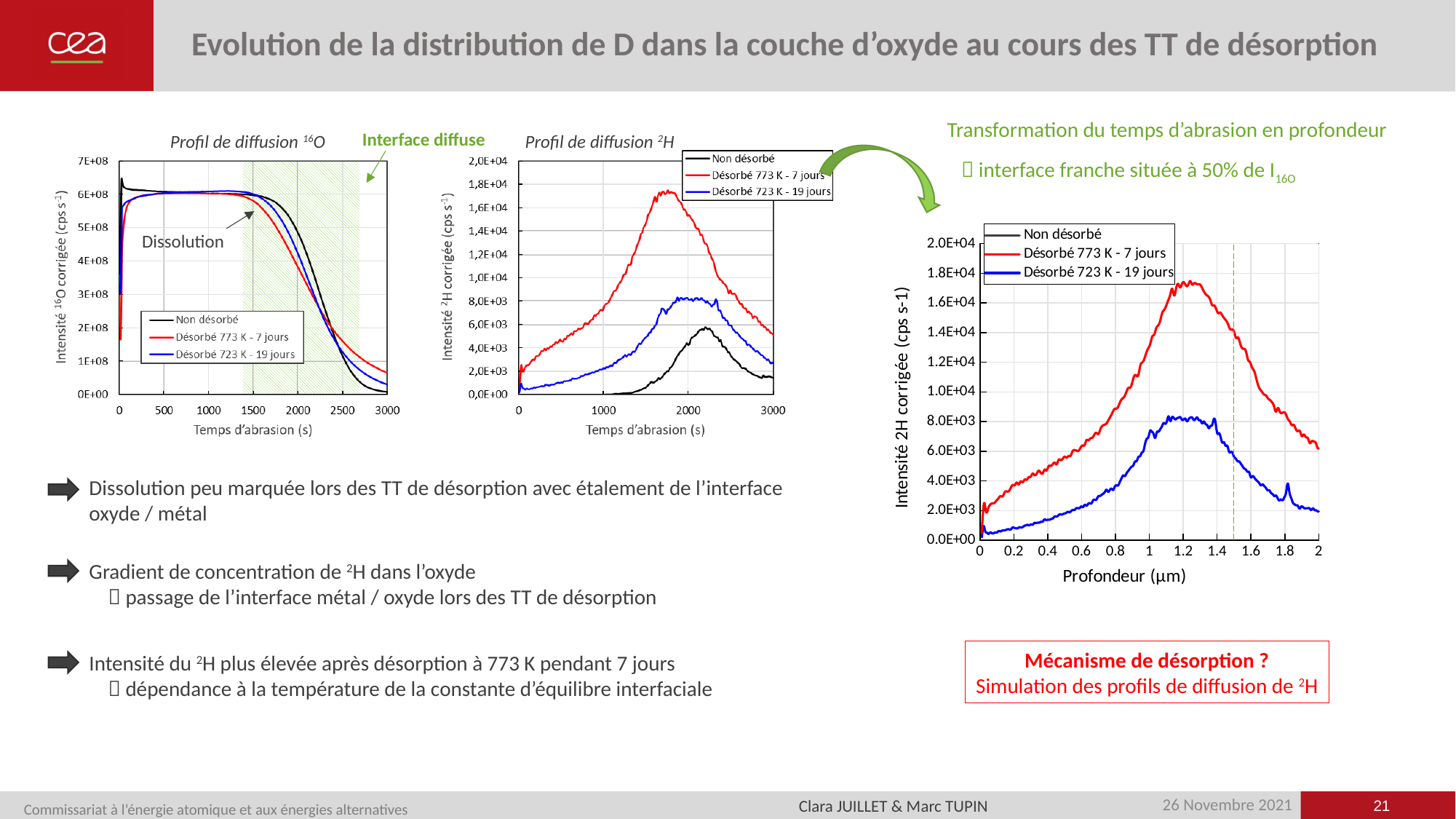
In the 'Profil de diffusion 2H' chart, which series has the lowest peak intensity? Non désorbé What is the x-axis label of the chart on the right of the slide? Profondeur (µm) In the 'Profil de diffusion 16O' chart, do the intensity values rise or fall between 1500 s and 3000 s of abrasion time? fall In the 'Profil de diffusion 2H' chart, which series has the larger peak: 'Désorbé 723 K - 19 jours' or 'Non désorbé'? Désorbé 723 K - 19 jours What kind of chart is the 'Profil de diffusion 16O' chart? line chart In the 'Profil de diffusion 16O' chart, is the value of the 'Non désorbé' series at 3000 s greater or less than 1E+08? less In the 'Profil de diffusion 2H' chart, is the peak value of the 'Désorbé 723 K - 19 jours' series greater or less than 1,0E+04? less In the 'Profil de diffusion 2H' chart, is the peak value of the 'Désorbé 773 K - 7 jours' series greater or less than 1,6E+04? greater What colour is the 'Désorbé 723 K - 19 jours' series in the 'Profil de diffusion 2H' chart? blue In the 'Profil de diffusion 2H' chart, which series reaches the highest peak intensity? Désorbé 773 K - 7 jours How many series does the legend of the 'Profil de diffusion 2H' chart list? 3